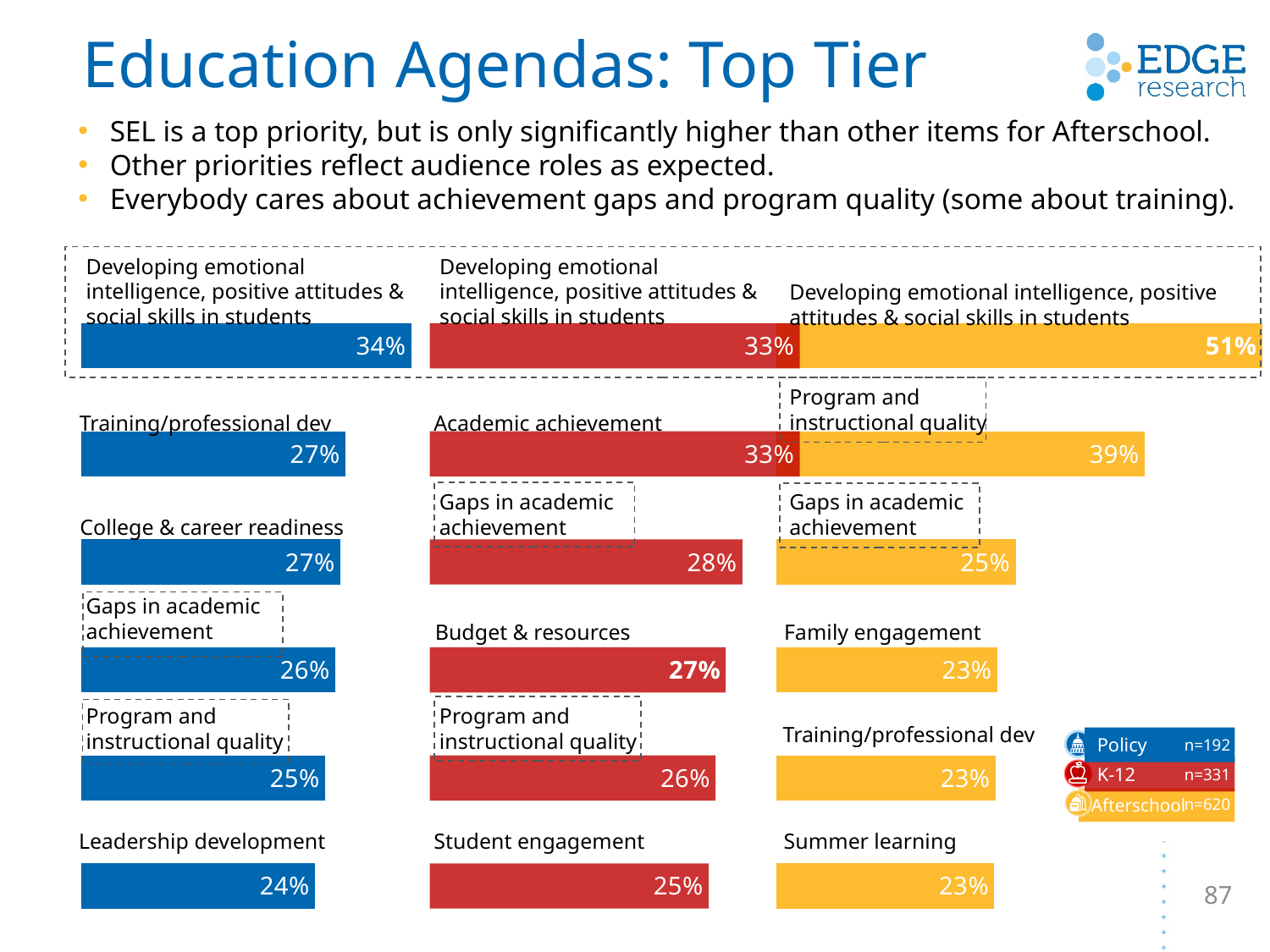
In the middle (red, K-12) chart, which is larger: Gaps in academic achievement or Student engagement? Gaps in academic achievement In the left (blue, Policy) chart, which category has the lowest value? Leadership development In the left (blue, Policy) chart, what is the difference between the value for Developing emotional intelligence, positive attitudes & social skills in students and the value for Gaps in academic achievement? 8% What colour are the bars for the K-12 audience? Red How many bars are shown in the middle (red, K-12) chart? 6 In the right (yellow, Afterschool) chart, what is the value for Program and instructional quality? 39% In the right (yellow, Afterschool) chart, what is the difference between the value for Developing emotional intelligence, positive attitudes & social skills in students and the value for Program and instructional quality? 12% In the right (yellow, Afterschool) chart, which category has the highest value? Developing emotional intelligence, positive attitudes & social skills in students What kind of chart is used on this slide? Bar chart According to the legend, what is the sample size (n) for the Afterschool audience? n=620 In the middle (red, K-12) chart, what is the value for Budget & resources? 27% In the left (blue, Policy) chart, what is the value for Leadership development? 24%